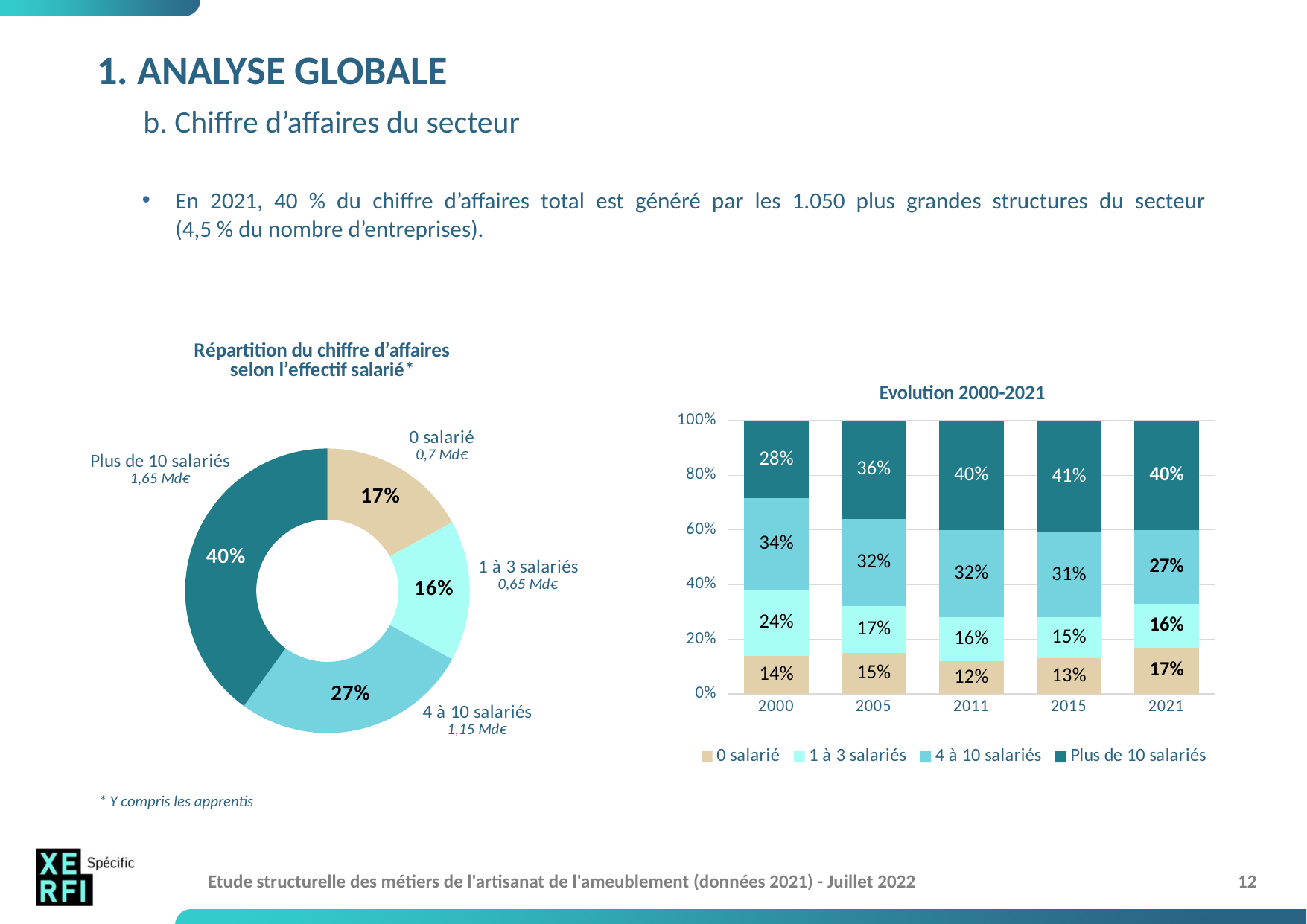
How many categories does the 'Répartition du chiffre d'affaires selon l'effectif salarié' chart show? 4 How many series does the legend of the 'Evolution 2000-2021' chart list? 4 In the 'Evolution 2000-2021' chart, does the '1 à 3 salariés' share rise or fall from 2000 to 2015? Fall In the 'Répartition du chiffre d'affaires selon l'effectif salarié' chart, what share is shown for 'Plus de 10 salariés'? 40% In the 'Répartition du chiffre d'affaires selon l'effectif salarié' chart, which category has the smallest share? 1 à 3 salariés In the 'Evolution 2000-2021' chart, what is the difference between the '4 à 10 salariés' value in 2000 and in 2021? 7 percentage points In the 'Evolution 2000-2021' chart, in which year is the 'Plus de 10 salariés' share highest? 2015 In the 'Evolution 2000-2021' chart, is the '1 à 3 salariés' value larger in 2000 or in 2015? 2000 In the 'Evolution 2000-2021' chart, what is the value for 'Plus de 10 salariés' in 2005? 36% In the 'Evolution 2000-2021' chart, what is the value for '0 salarié' in 2011? 12% What kind of chart is the 'Répartition du chiffre d'affaires selon l'effectif salarié' chart? Doughnut (pie) chart In the 'Répartition du chiffre d'affaires selon l'effectif salarié' chart, what amount in Md€ is shown for '4 à 10 salariés'? 1,15 Md€